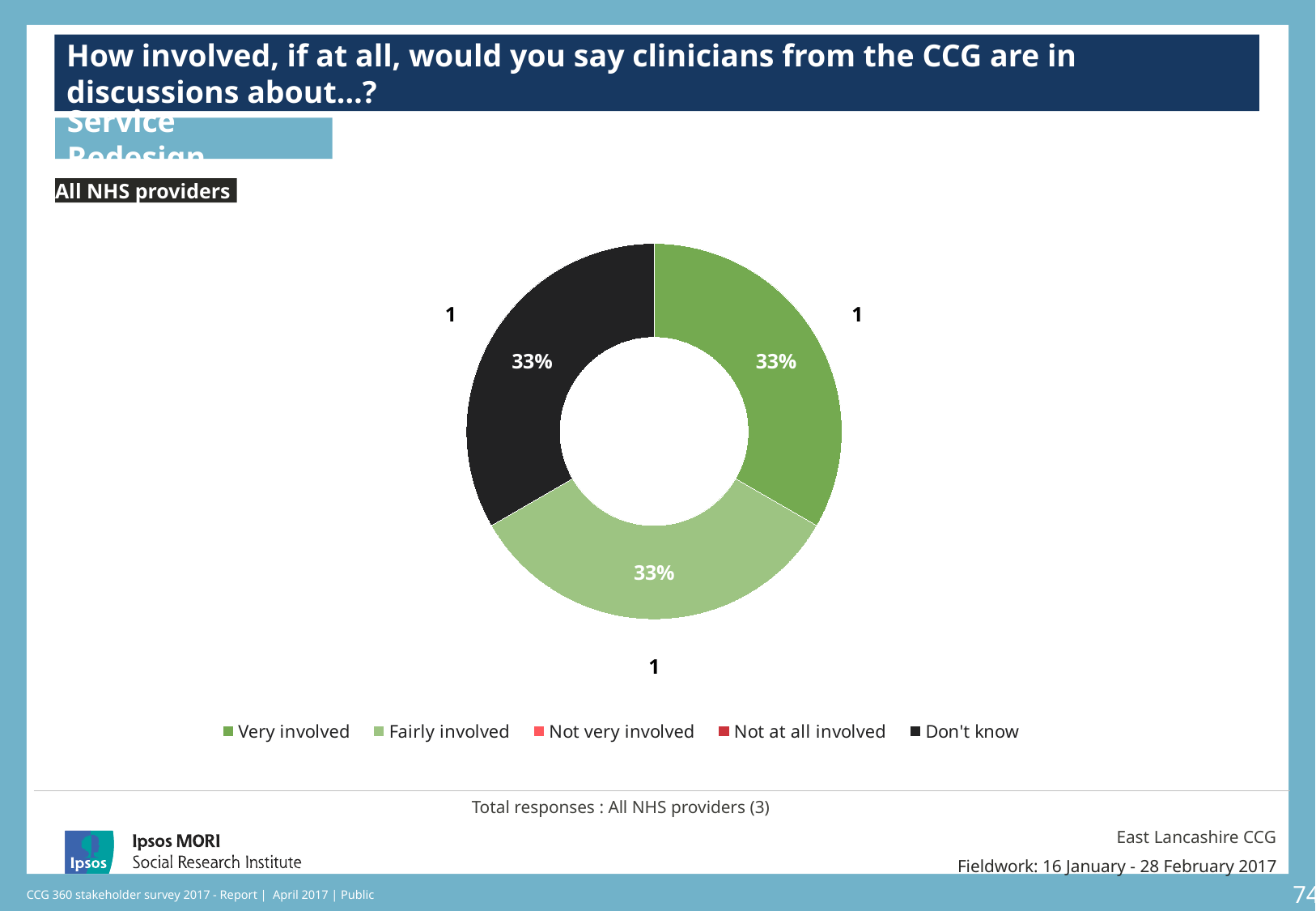
How many categories does the legend list? 5 Which legend category is shown in black in the chart? Don't know What is the total number of responses from All NHS providers shown on the slide? 3 What percentage of All NHS providers said clinicians from the CCG are 'Very involved'? 33% What kind of chart is shown on the slide? Doughnut (pie) chart What percentage of All NHS providers answered 'Don't know'? 33% What share of the chart does the 'Fairly involved' slice take up? 33% Which respondent group does the chart cover, according to the label above it? All NHS providers What percentage of All NHS providers said clinicians from the CCG are 'Fairly involved'? 33% How many responses does the 'Don't know' slice represent, according to the count label next to it? 1 How many slices are visible in the doughnut chart? 3 How many responses does the 'Very involved' slice represent, according to the count label next to it? 1